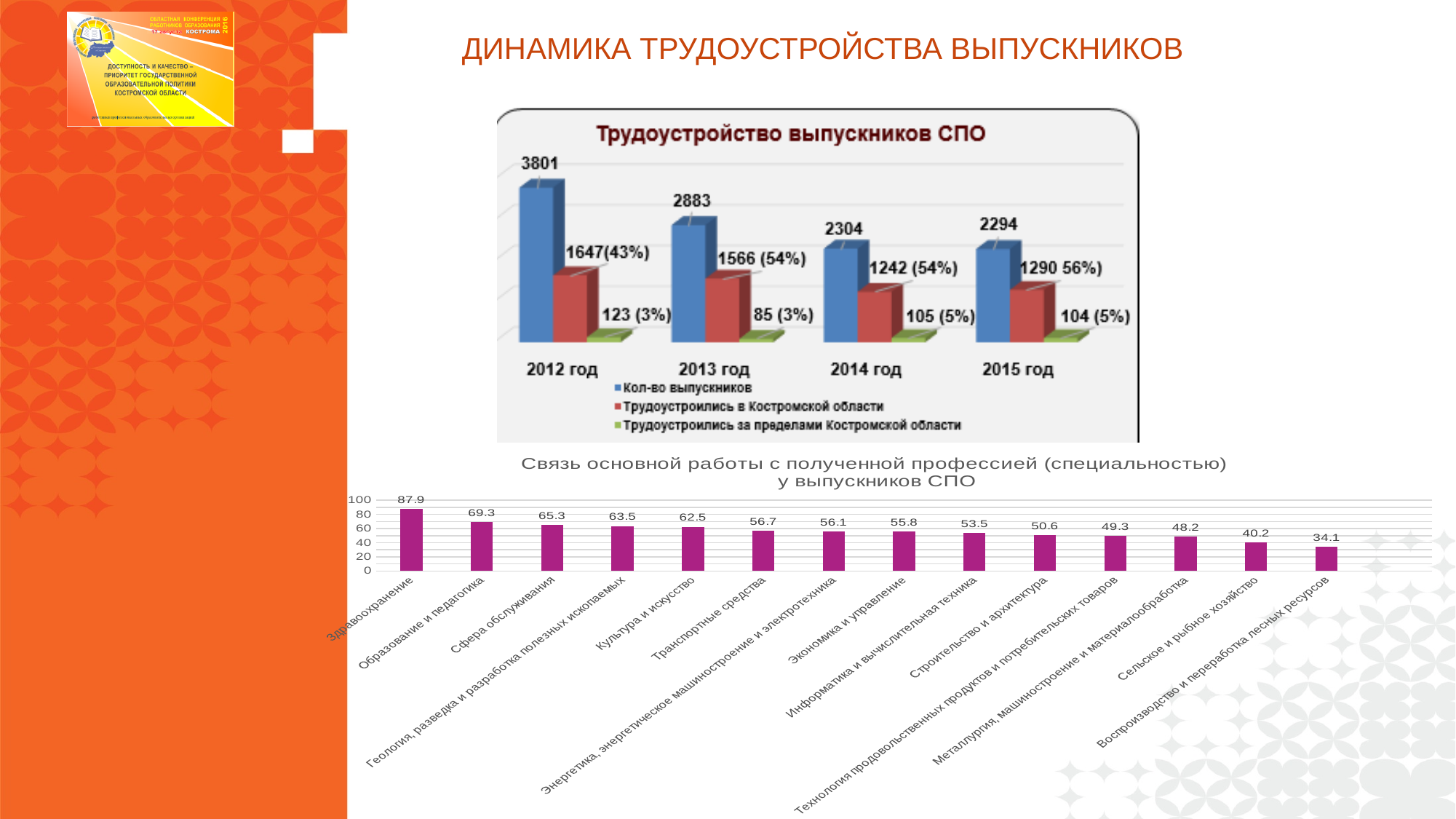
In the chart 'Трудоустройство выпускников СПО', does 'Кол-во выпускников' rise or fall from 2012 год to 2015 год? fall In the chart 'Связь основной работы с полученной профессией (специальностью) у выпускников СПО', how many categories are shown? 14 In the chart 'Трудоустройство выпускников СПО', what is the value of 'Кол-во выпускников' for 2012 год? 3801 In the chart 'Трудоустройство выпускников СПО', how many series does the legend list? 3 In the chart 'Трудоустройство выпускников СПО', what is the difference between 'Кол-во выпускников' in 2012 год and 2013 год? 918 In the chart 'Связь основной работы с полученной профессией (специальностью) у выпускников СПО', which category has the highest value? Здравоохранение In the chart 'Трудоустройство выпускников СПО', what is the value of 'Трудоустроились за пределами Костромской области' for 2013 год? 85 (3%) In the chart 'Связь основной работы с полученной профессией (специальностью) у выпускников СПО', what is the difference between 'Здравоохранение' and 'Сельское и рыбное хозяйство'? 47.7 In the chart 'Связь основной работы с полученной профессией (специальностью) у выпускников СПО', which category has the lowest value? Воспроизводство и переработка лесных ресурсов What kind of chart is the bottom chart 'Связь основной работы с полученной профессией (специальностью) у выпускников СПО'? bar chart In the chart 'Связь основной работы с полученной профессией (специальностью) у выпускников СПО', what is the value for 'Культура и искусство'? 62.5 In the chart 'Трудоустройство выпускников СПО', which year has the highest value of 'Кол-во выпускников'? 2012 год